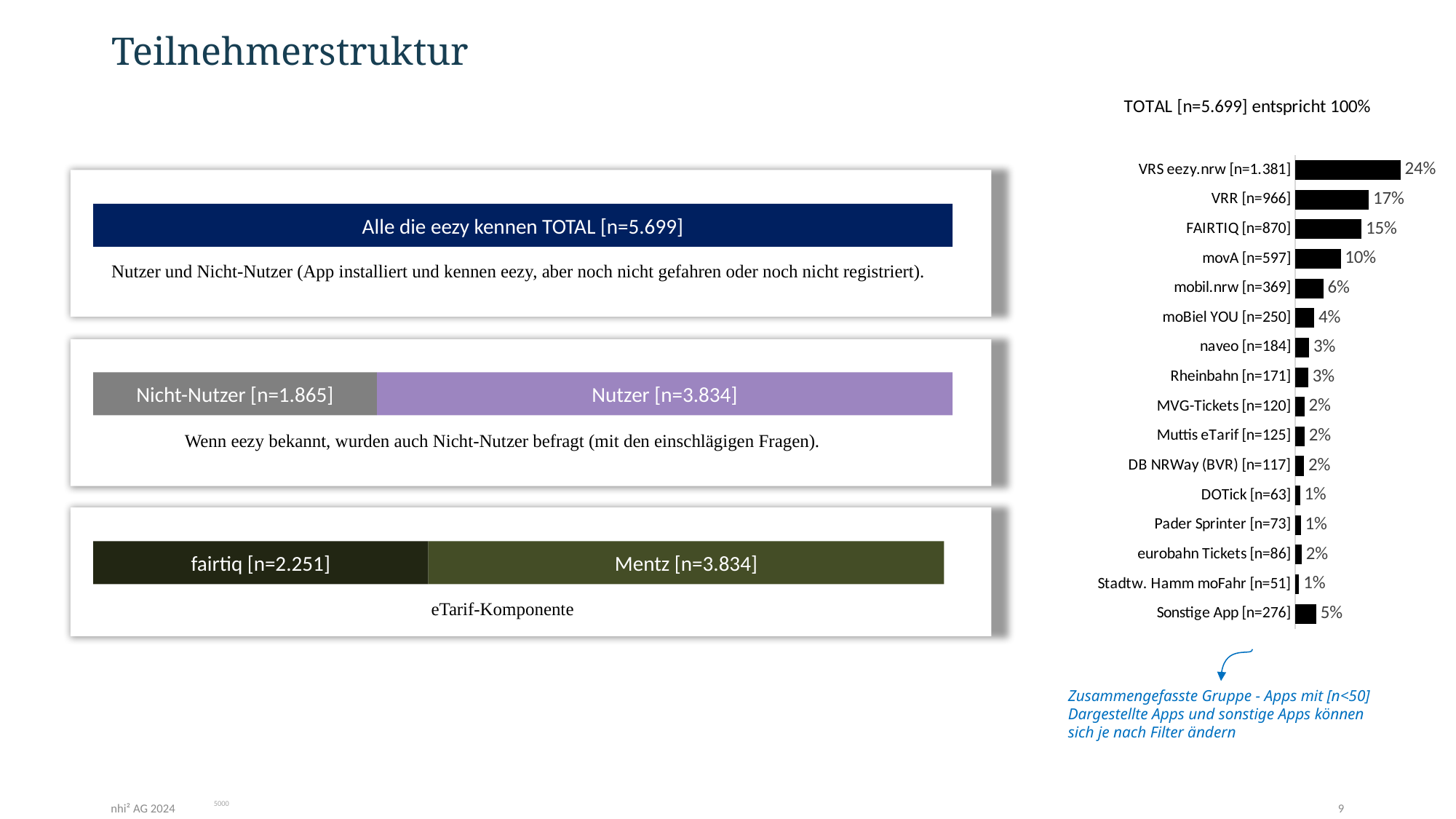
In the bar chart on the right, what is the difference between the values for VRS eezy.nrw [n=1.381] and VRR [n=966]? 7% In the bar chart on the right, what is the value for VRS eezy.nrw [n=1.381]? 24% In the bar chart on the right, which is larger, the value for movA [n=597] or the value for moBiel YOU [n=250]? movA [n=597] What kind of chart is shown on the right side of the slide? Bar chart In the bar chart on the right, what is the difference between the values for FAIRTIQ [n=870] and movA [n=597]? 5% In the bar chart on the right, what colour are the bars? Black According to the text above the bar chart on the right, what total n corresponds to 100%? n=5.699 In the bar chart on the right, what is the value for Sonstige App [n=276]? 5% In the bar chart on the right, what is the value for mobil.nrw [n=369]? 6% In the bar chart on the right, which category has the highest value? VRS eezy.nrw [n=1.381] In the bar chart on the right, what is the value for FAIRTIQ [n=870]? 15% How many categories does the bar chart on the right show? 16